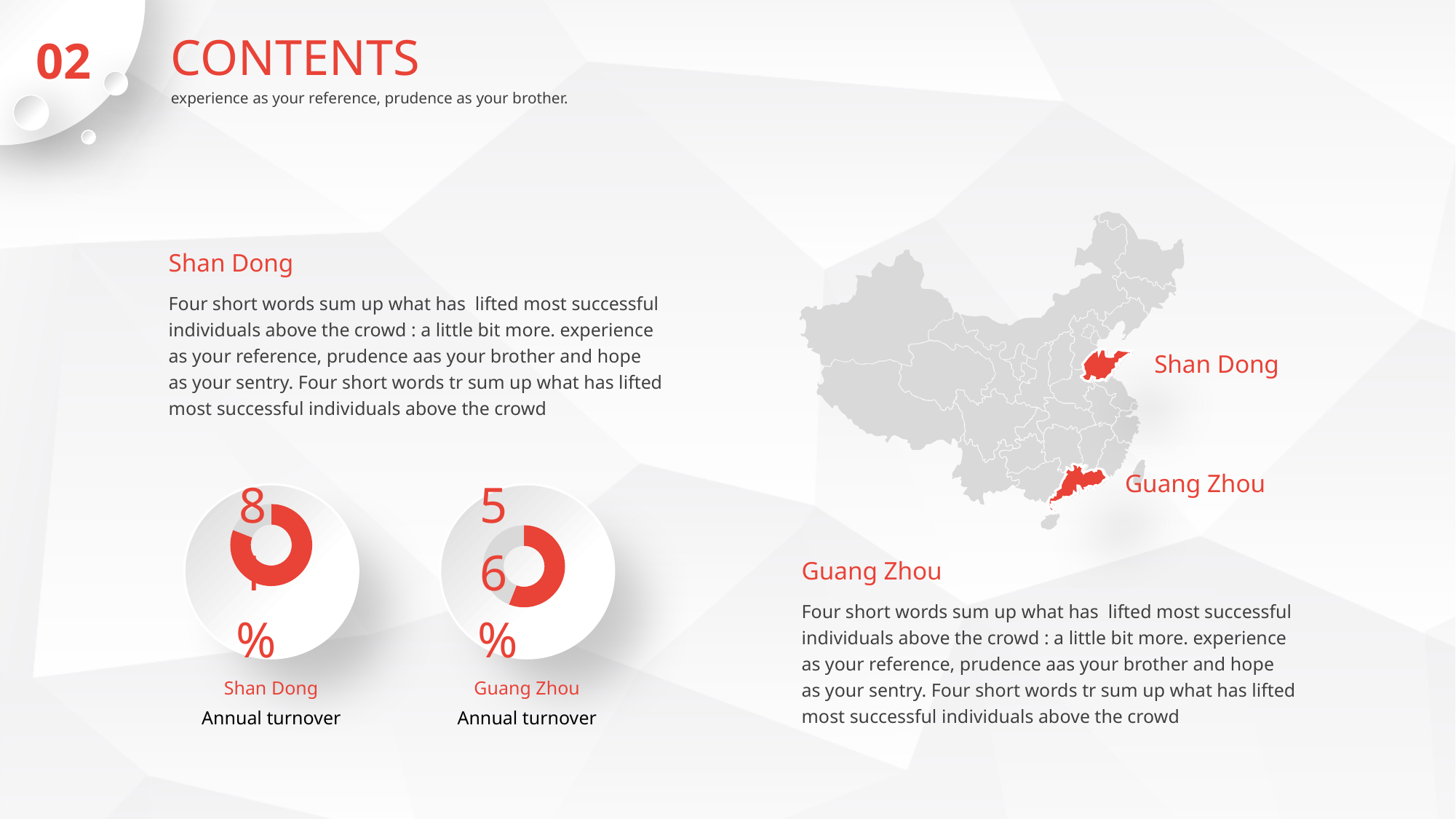
How many donut charts are shown on the slide? 2 In the Guang Zhou annual turnover donut chart, what percentage is printed? 56% What colour is the filled portion of the donut charts? Red What kind of chart is used to show the annual turnover for Shan Dong and Guang Zhou? Donut chart Which donut chart shows a larger filled share, Shan Dong or Guang Zhou? Shan Dong Which region's donut chart is positioned on the right of the two charts? Guang Zhou What label appears below the left donut chart, under the name Shan Dong? Annual turnover